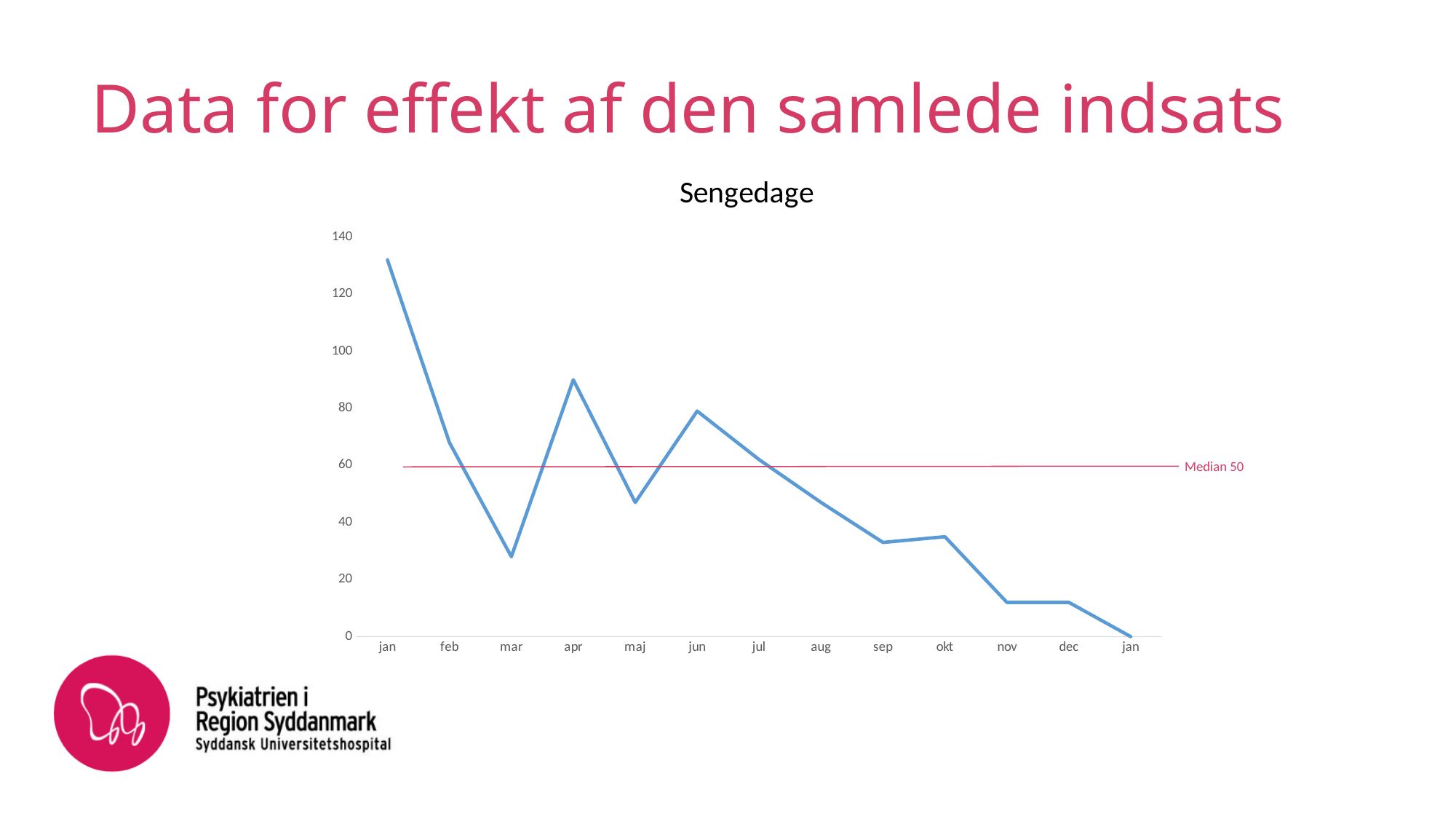
Is the value for apr greater or less than 80? greater Is the value for mar greater or less than 40? less What is the label on the horizontal reference line? Median 50 What kind of chart is shown on the slide? line chart Which month has the highest value? jan (the first one) How many data points are plotted on the line? 13 Which is larger, the value for apr or the value for jun? apr What is the title of the chart? Sengedage What is the value for the final jan point? 0 Is the value for the first jan greater or less than 120? greater Do the values generally rise or fall from the first jan to the last jan? fall Which month has the lowest value? jan (the last one)